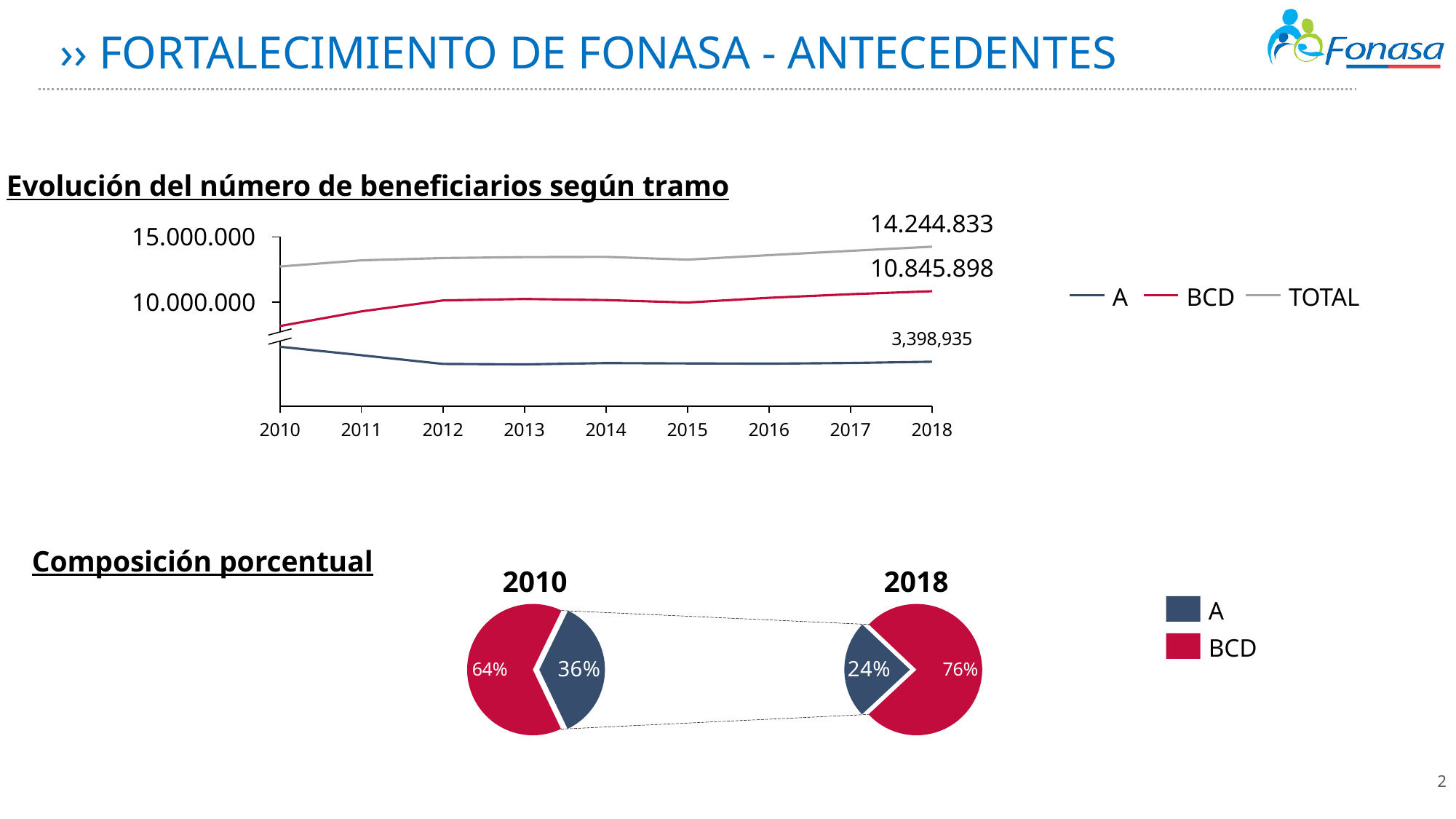
In the line chart 'Evolución del número de beneficiarios según tramo', does series A rise or fall between 2010 and 2012? Fall In the 2010 pie chart under 'Composición porcentual', what share does BCD have? 64% In the line chart 'Evolución del número de beneficiarios según tramo', is the BCD value in 2010 greater or less than 10.000.000? less In the line chart 'Evolución del número de beneficiarios según tramo', what is the value of the TOTAL series in 2018? 14.244.833 In the 2018 pie chart under 'Composición porcentual', what share does A have? 24% What kind of chart is 'Evolución del número de beneficiarios según tramo'? Line chart In the line chart 'Evolución del número de beneficiarios según tramo', what is the value of the BCD series in 2018? 10.845.898 In the line chart 'Evolución del número de beneficiarios según tramo', how many years are shown on the x axis? 9 Under 'Composición porcentual', which pie chart has the larger share for BCD, 2010 or 2018? 2018 In the line chart 'Evolución del número de beneficiarios según tramo', is the TOTAL value in 2010 greater or less than 10.000.000? greater In the line chart 'Evolución del número de beneficiarios según tramo', how many series does the legend list? 3 In the line chart 'Evolución del número de beneficiarios según tramo', what is the value of series A in 2018? 3,398,935